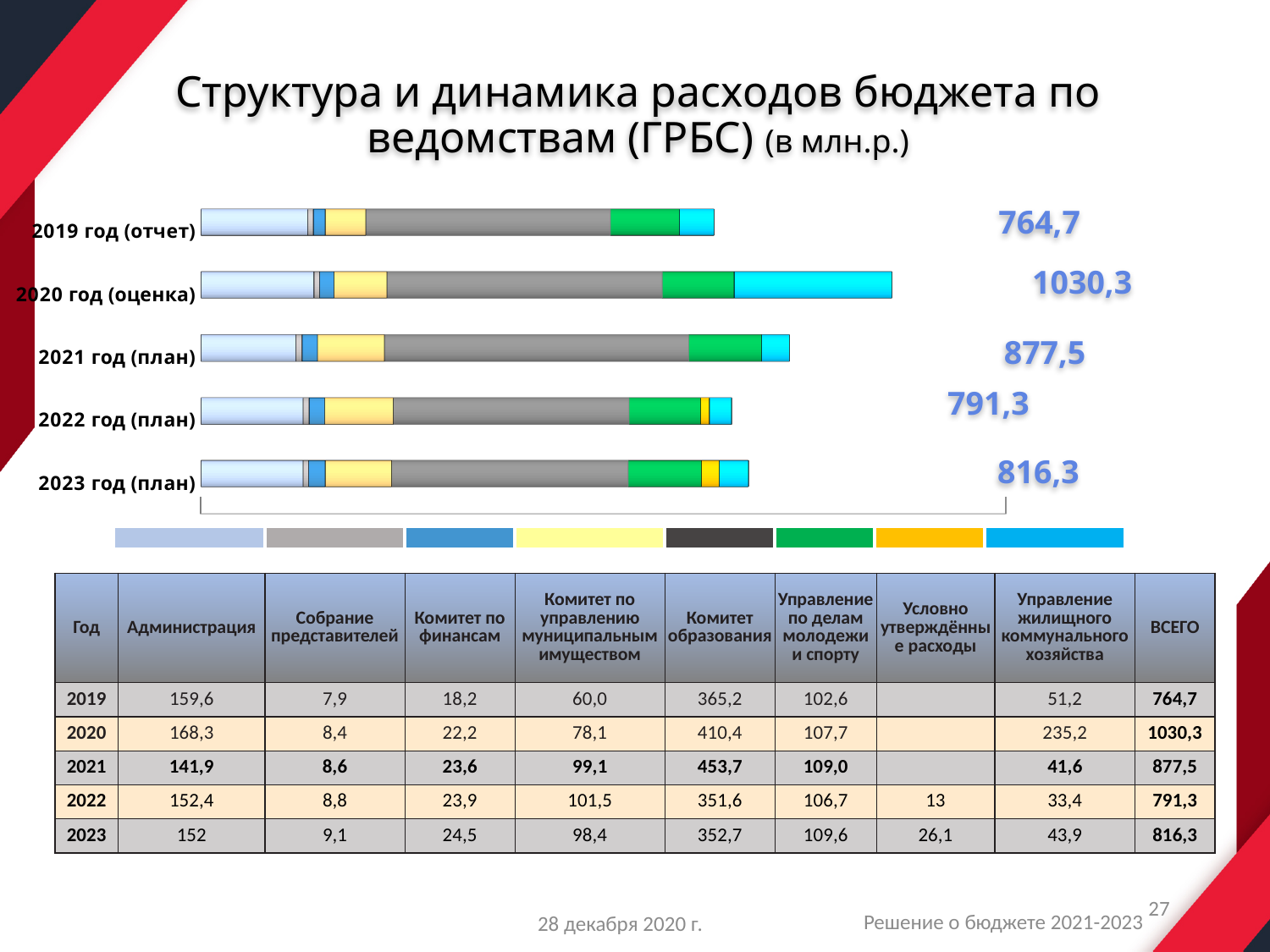
Do the totals rise or fall from 2020 год (оценка) to 2022 год (план)? Fall What is the difference between the totals for 2021 год (план) and 2022 год (план)? 86,2 Which year has the lowest total in the chart? 2019 год (отчет) How many bars (years) are shown in the chart? 5 What is the difference between the totals for 2020 год (оценка) and 2019 год (отчет)? 265,6 What is the total value shown for 2021 год (план)? 877,5 What is the total value shown for 2020 год (оценка)? 1030,3 What is the total value shown for 2019 год (отчет)? 764,7 What kind of chart is shown on the slide? Stacked bar chart Which has the larger total, 2021 год (план) or 2023 год (план)? 2021 год (план) What is the total value shown for 2023 год (план)? 816,3 Which year has the highest total in the chart? 2020 год (оценка)